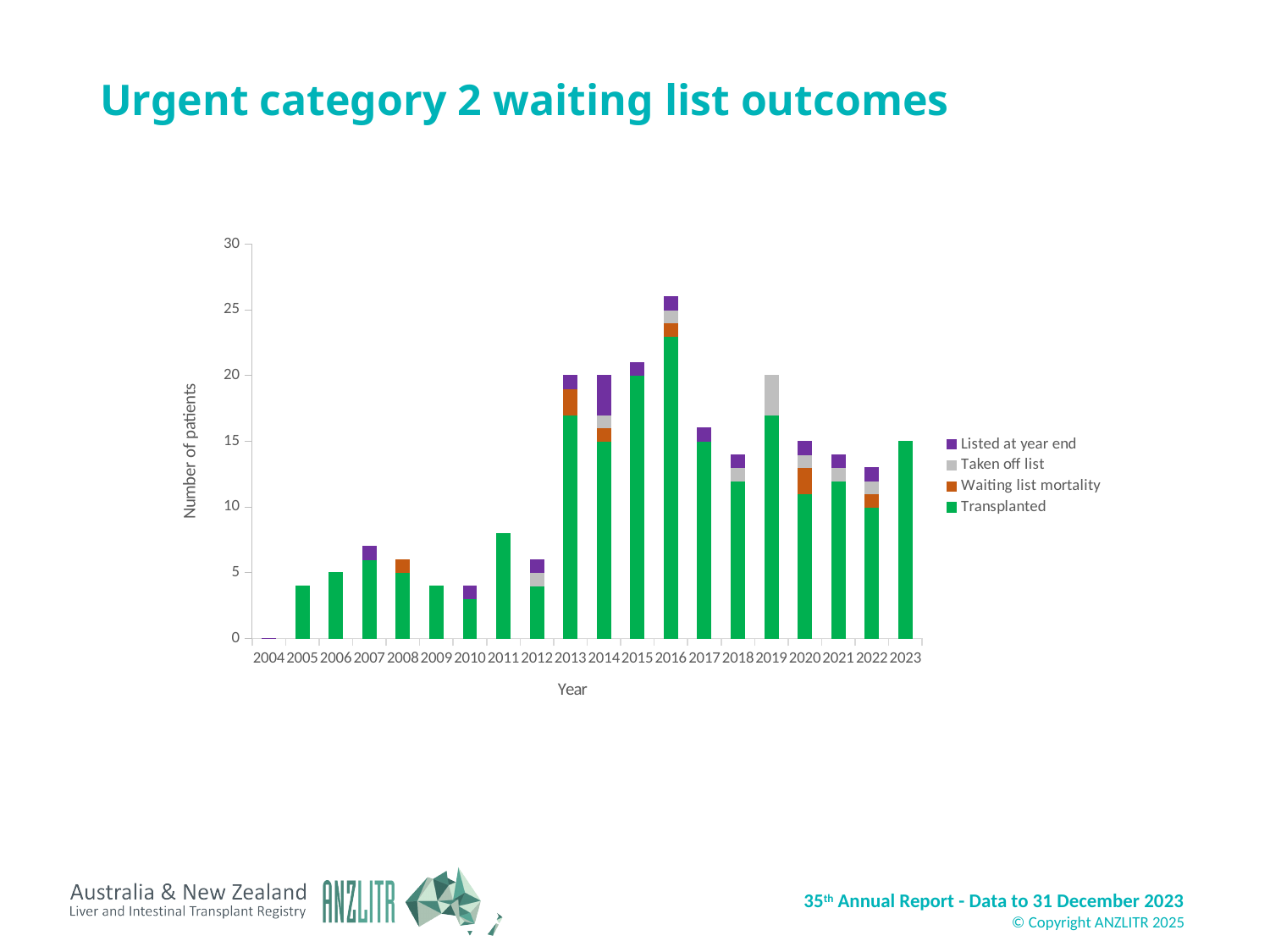
What is the total number of patients for 2023? 15 Which year has the larger total, 2011 or 2012? 2011 What is the total number of patients for 2013? 20 Which year has the smallest bar? 2004 Is the total for 2016 greater or less than 25? greater Which colour represents the Transplanted series? Green How many years are shown on the x axis? 20 What kind of chart is shown on the slide? Stacked bar chart Which year has the tallest bar? 2016 Do the bar totals generally rise or fall from 2009 to 2016? Rise How many series does the legend list? 4 Is the total for 2011 greater or less than 10? less